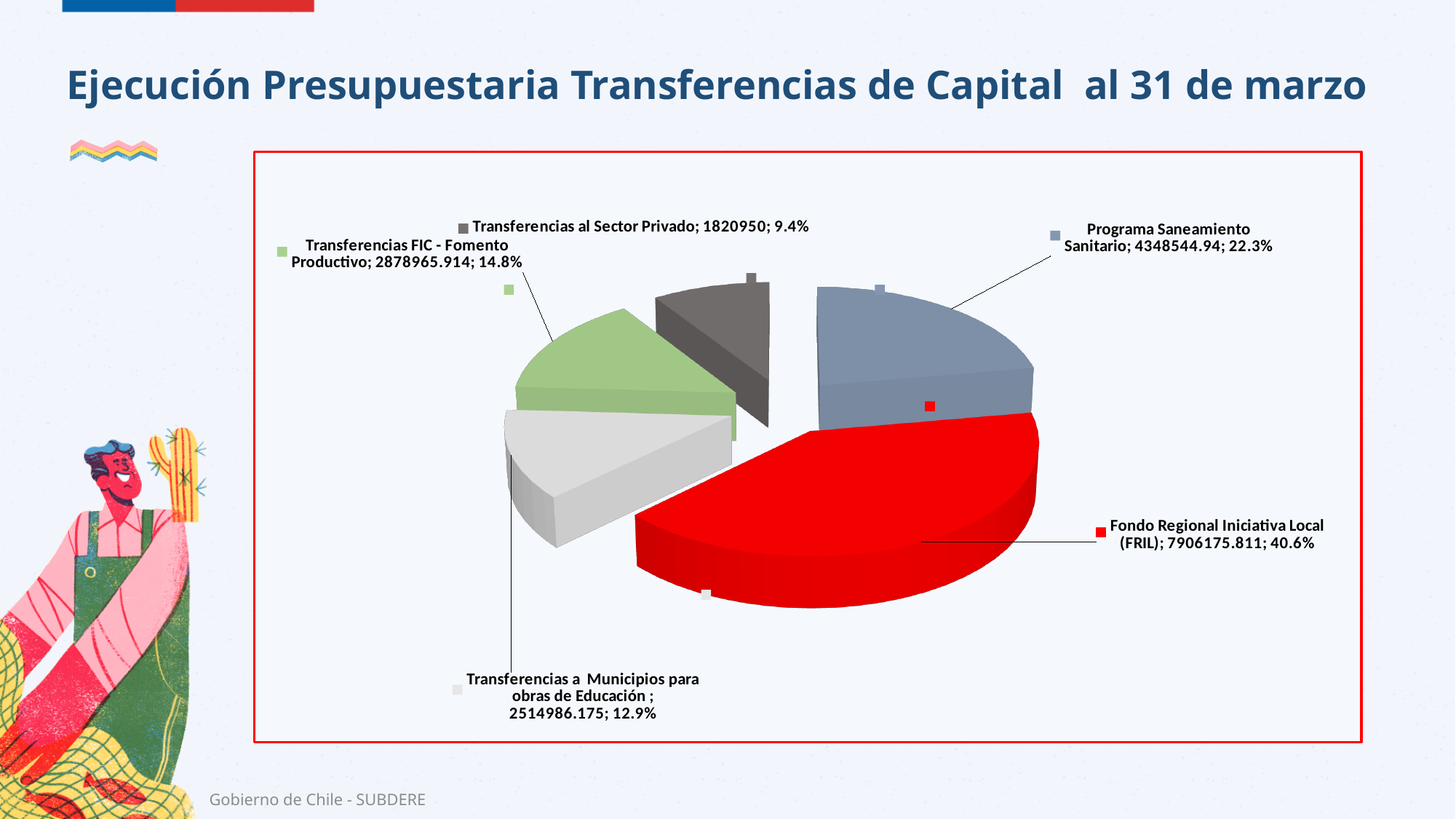
What value is shown for Fondo Regional Iniciativa Local (FRIL)? 7906175.811 Which is larger, the value for Programa Saneamiento Sanitario or the value for Transferencias FIC - Fomento Productivo? Programa Saneamiento Sanitario What is the difference in percentage share between Fondo Regional Iniciativa Local (FRIL) and Programa Saneamiento Sanitario? 18.3% What is the title of the slide containing the pie chart? Ejecución Presupuestaria Transferencias de Capital al 31 de marzo Which category has the smallest slice of the pie? Transferencias al Sector Privado What value is shown for Transferencias al Sector Privado? 1820950 What share of the pie does Transferencias a Municipios para obras de Educación represent? 12.9% Which category has the largest slice of the pie? Fondo Regional Iniciativa Local (FRIL) What value is shown for Programa Saneamiento Sanitario? 4348544.94 How many slices does the pie chart have? 5 What kind of chart is shown on the slide? Pie chart What share of the pie does Transferencias FIC - Fomento Productivo represent? 14.8%